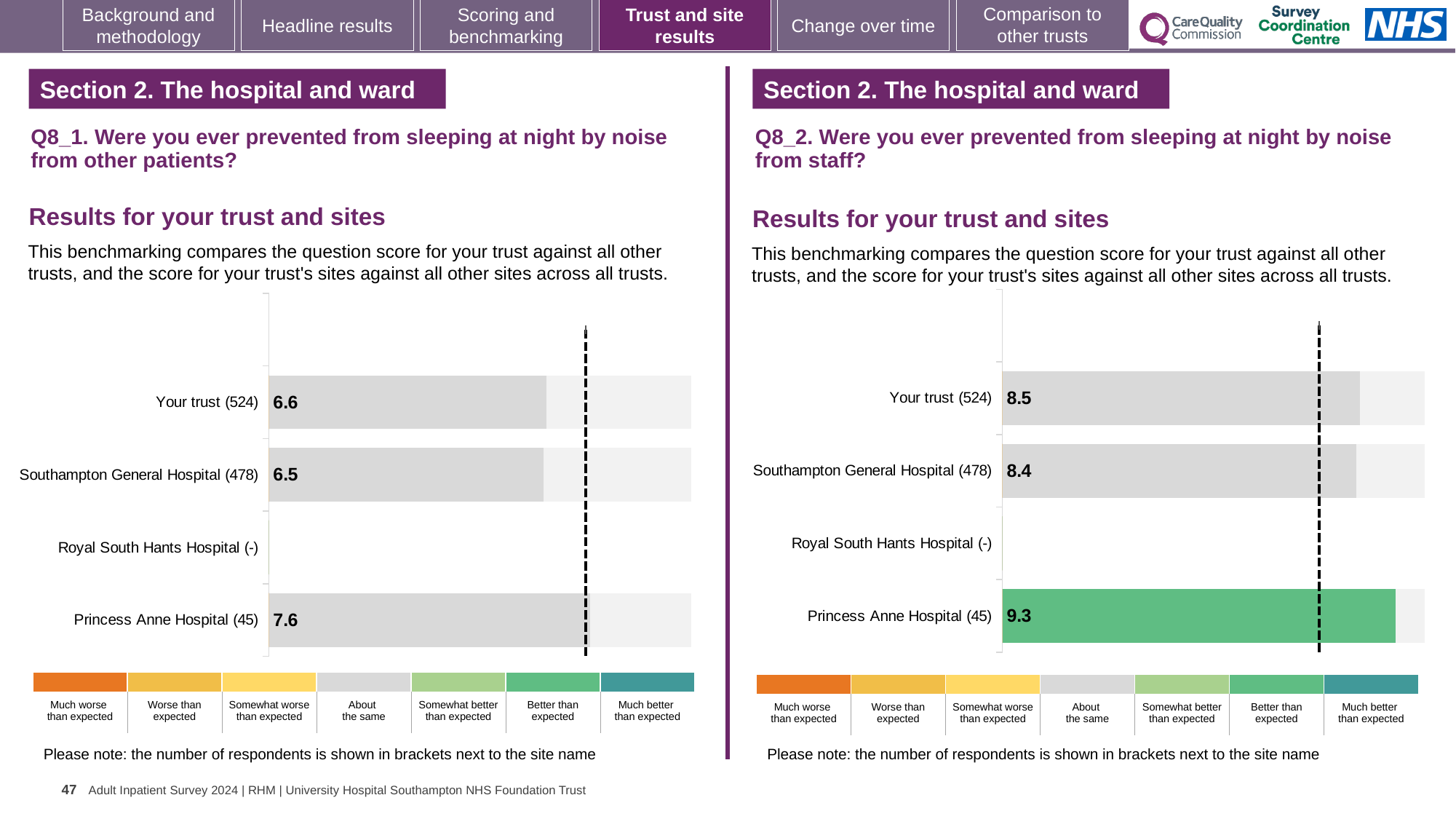
In the Q8_2 chart (noise from staff), what is the score for Princess Anne Hospital (45)? 9.3 In the Q8_1 chart (noise from other patients), what is the difference between the scores for Princess Anne Hospital and Your trust? 1.0 In the Q8_1 chart (noise from other patients), what is the score for Your trust (524)? 6.6 How many sites or trusts are listed on the Q8_1 chart (noise from other patients), including the one with no score? 4 In the Q8_1 chart (noise from other patients), which site or trust has the highest score? Princess Anne Hospital (45) In the Q8_1 chart (noise from other patients), what is the score for Princess Anne Hospital (45)? 7.6 In the Q8_2 chart (noise from staff), which has the larger score: Your trust or Princess Anne Hospital? Princess Anne Hospital In the Q8_2 chart (noise from staff), which site or trust has the lowest score? Southampton General Hospital (478) In the Q8_2 chart (noise from staff), what is the difference between the scores for Princess Anne Hospital and Southampton General Hospital? 0.9 In the Q8_2 chart (noise from staff), which benchmark category does the green bar for Princess Anne Hospital correspond to in the colour key? Better than expected In the Q8_2 chart (noise from staff), what is the score for Southampton General Hospital (478)? 8.4 What kind of chart is used for the Q8_2 results (noise from staff)? Bar chart